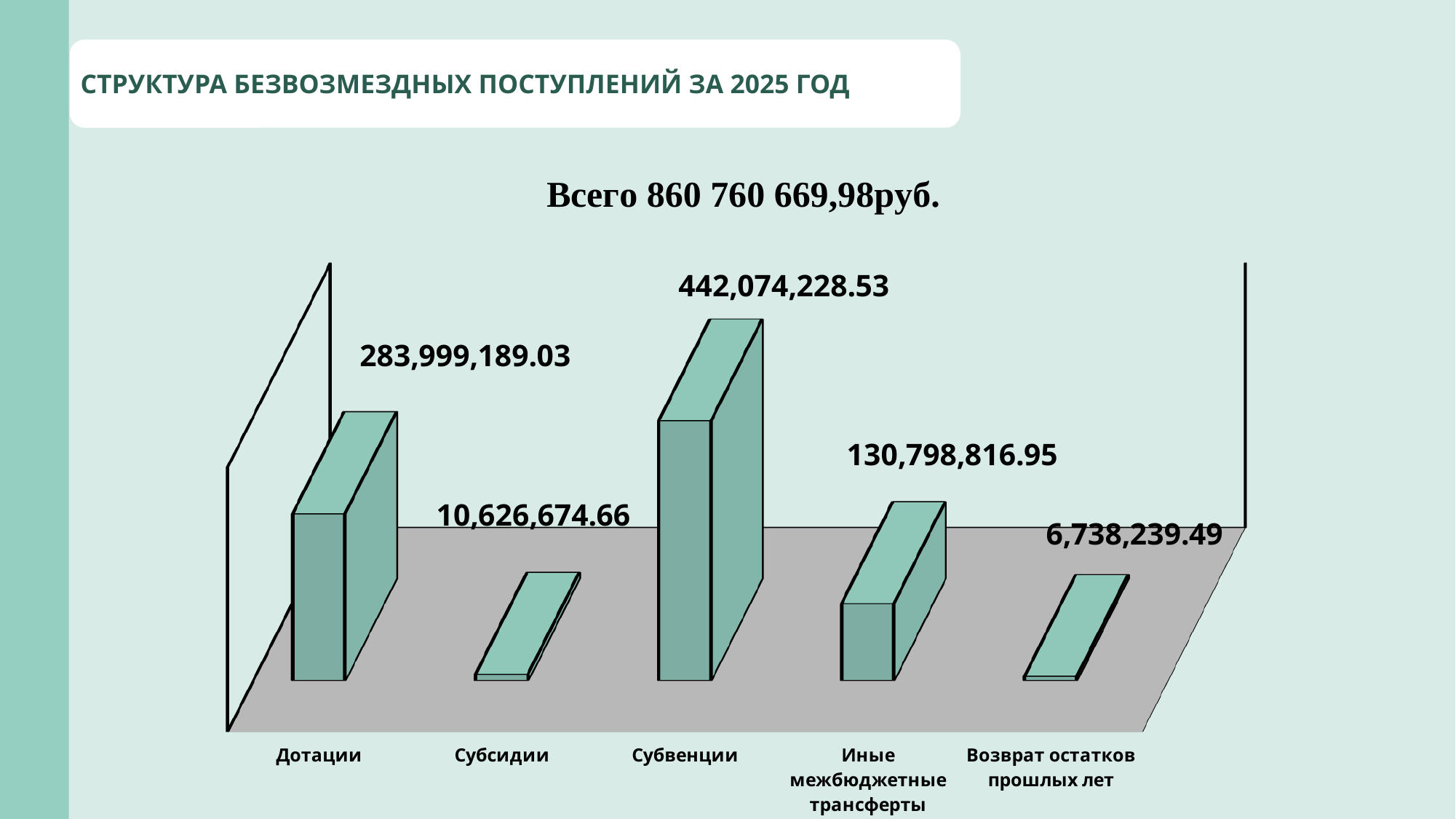
What is the value for Субвенции? 442,074,228.53 Which is larger, the value for Субсидии or the value for Иные межбюджетные трансферты? Иные межбюджетные трансферты What total amount is stated in the chart title? 860 760 669,98руб. What kind of chart is shown on the slide? Bar chart What is the difference between the values for Субсидии and Возврат остатков прошлых лет? 3,888,435.17 What is the difference between the values for Субвенции and Дотации? 158,075,039.50 What is the value for Дотации? 283,999,189.03 Which category has the highest value? Субвенции How many categories are shown in the chart? 5 What is the value for Возврат остатков прошлых лет? 6,738,239.49 What is the value for Иные межбюджетные трансферты? 130,798,816.95 Which category has the lowest value? Возврат остатков прошлых лет